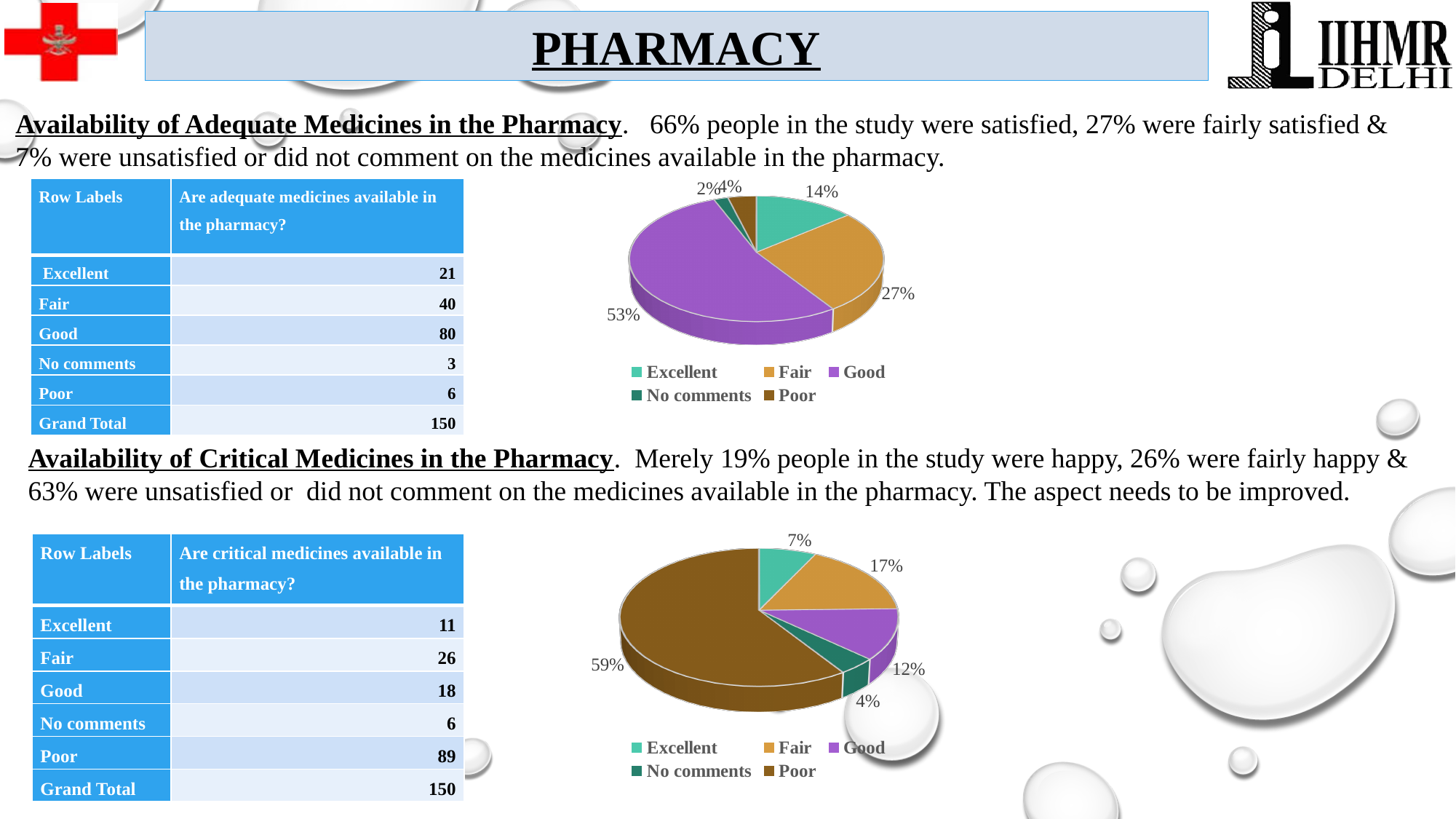
In the bottom pie chart, what share is labelled for the Excellent slice? 7% In the top pie chart, what share is labelled for the Fair slice? 27% In the top pie chart, which category has the smallest slice? No comments How many categories does the legend of the top pie chart list? 5 In the top pie chart, what share is labelled for the Good slice? 53% In the bottom pie chart, which category has the largest slice? Poor What type of chart is the top chart on the slide? Pie chart In the top pie chart, what is the difference between the Good share and the Fair share? 26% In the bottom pie chart, what colour is the Poor slice? Brown In the bottom pie chart, what share is labelled for the Poor slice? 59% In the bottom pie chart, which is larger, the Fair slice or the Good slice? Fair In the top pie chart, which category has the largest slice? Good